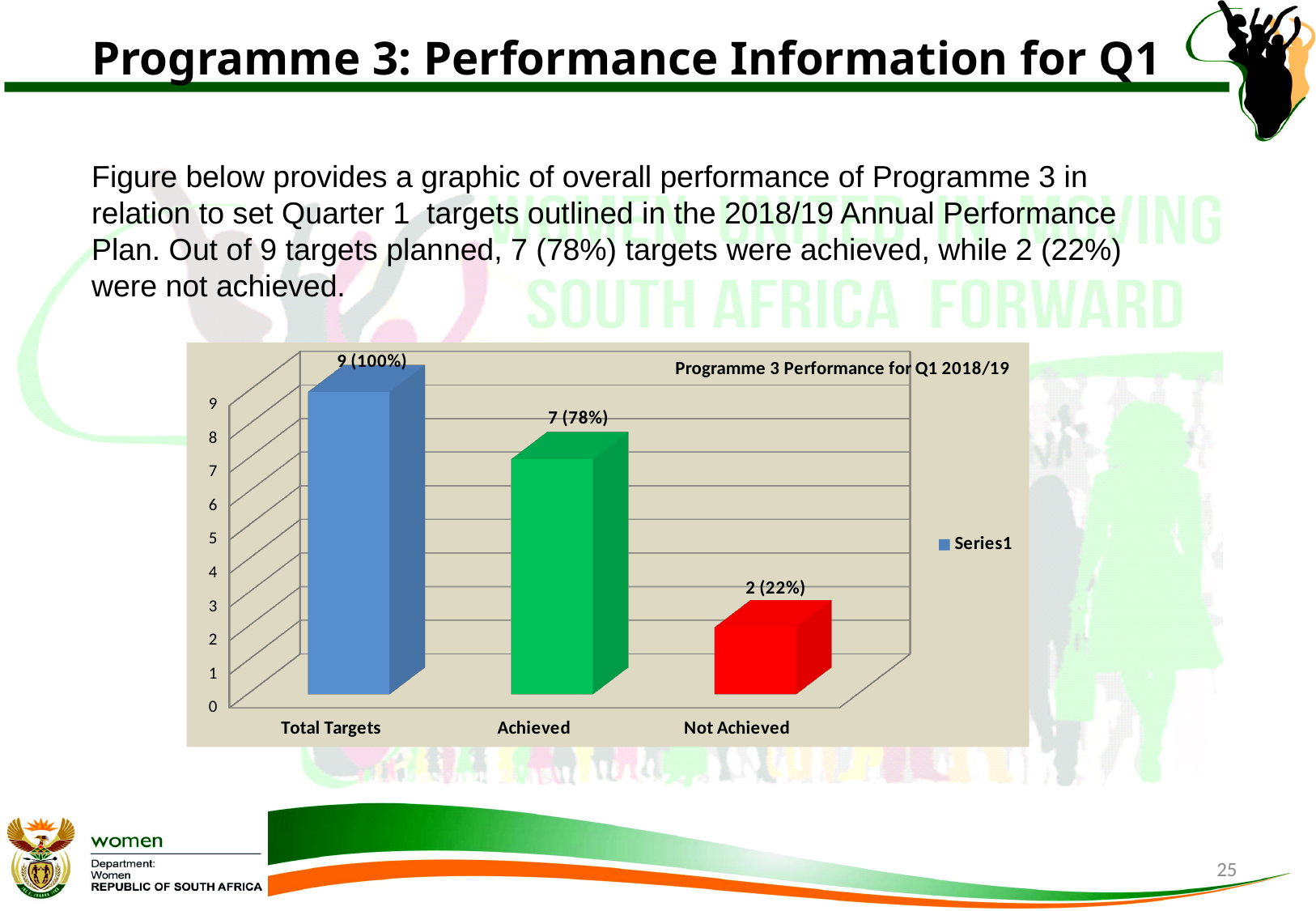
Is the value for Achieved greater or less than 5? greater Which category has the lowest value? Not Achieved How many categories are shown on the x axis? 3 What kind of chart is shown on the slide? Bar chart What is the data label shown for Total Targets? 9 (100%) What is the title of the chart? Programme 3 Performance for Q1 2018/19 Which category has the highest value? Total Targets How many series does the legend list? 1 What is the data label shown for Achieved? 7 (78%) Which is larger, the value for Achieved or the value for Not Achieved? Achieved What is the difference between the Achieved value and the Not Achieved value? 5 What is the data label shown for Not Achieved? 2 (22%)